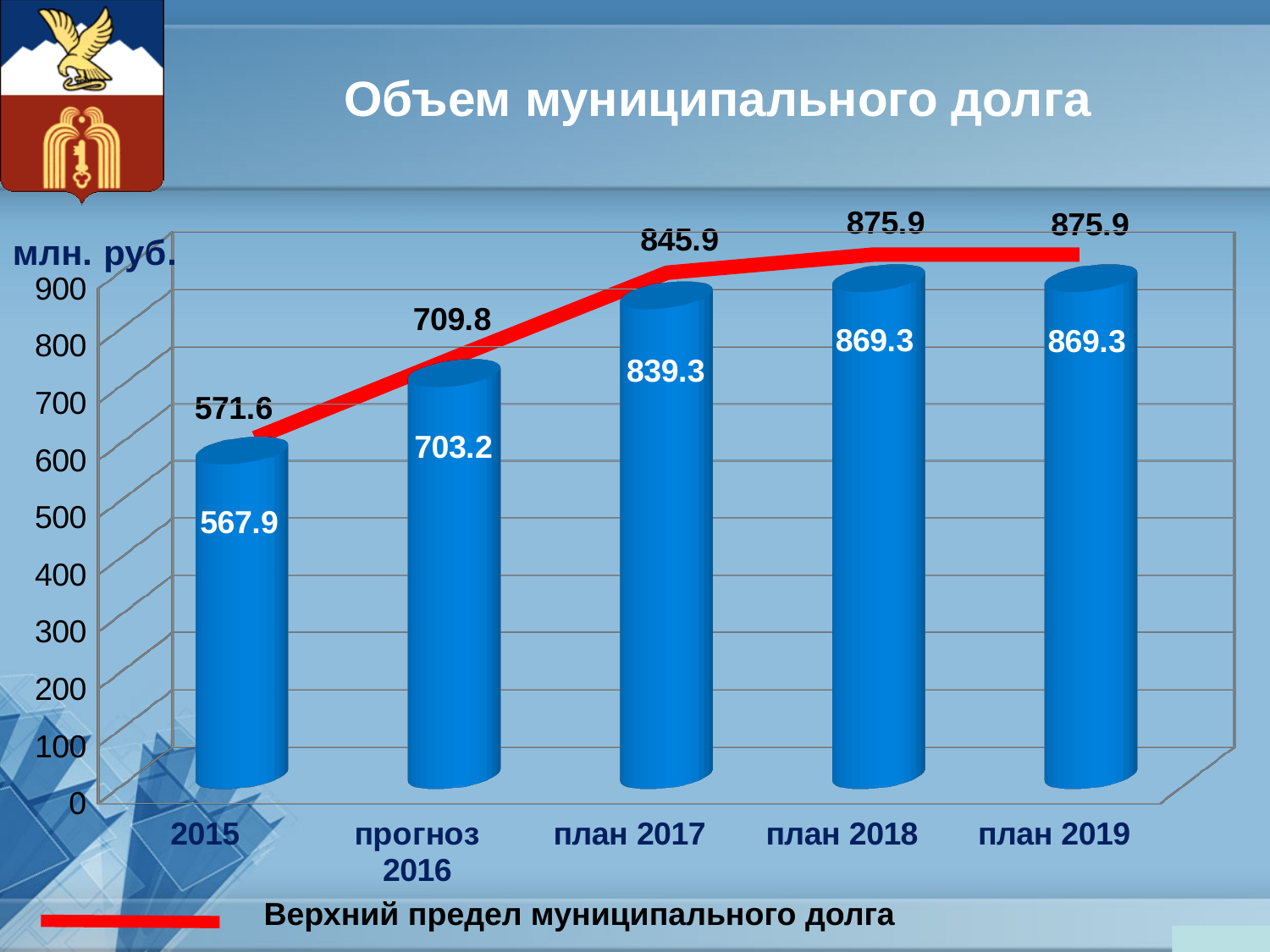
How many categories are shown on the x axis? 5 What is the difference between the red line value and the bar value for план 2019? 6.6 What is the value of the red line (Верхний предел муниципального долга) for план 2018? 875.9 What is the value of the bar for план 2017? 839.3 What is the difference between the bar values for план 2017 and прогноз 2016? 136.1 Which is larger, the bar value for прогноз 2016 or the bar value for план 2017? план 2017 What is the value of the red line (Верхний предел муниципального долга) for прогноз 2016? 709.8 What is the value of the bar for 2015? 567.9 Do the bar values rise or fall from 2015 to план 2018? rise What unit is shown for the values on the chart? млн. руб. What kind of chart is shown on the slide? bar chart with a line Which category has the lowest bar value? 2015